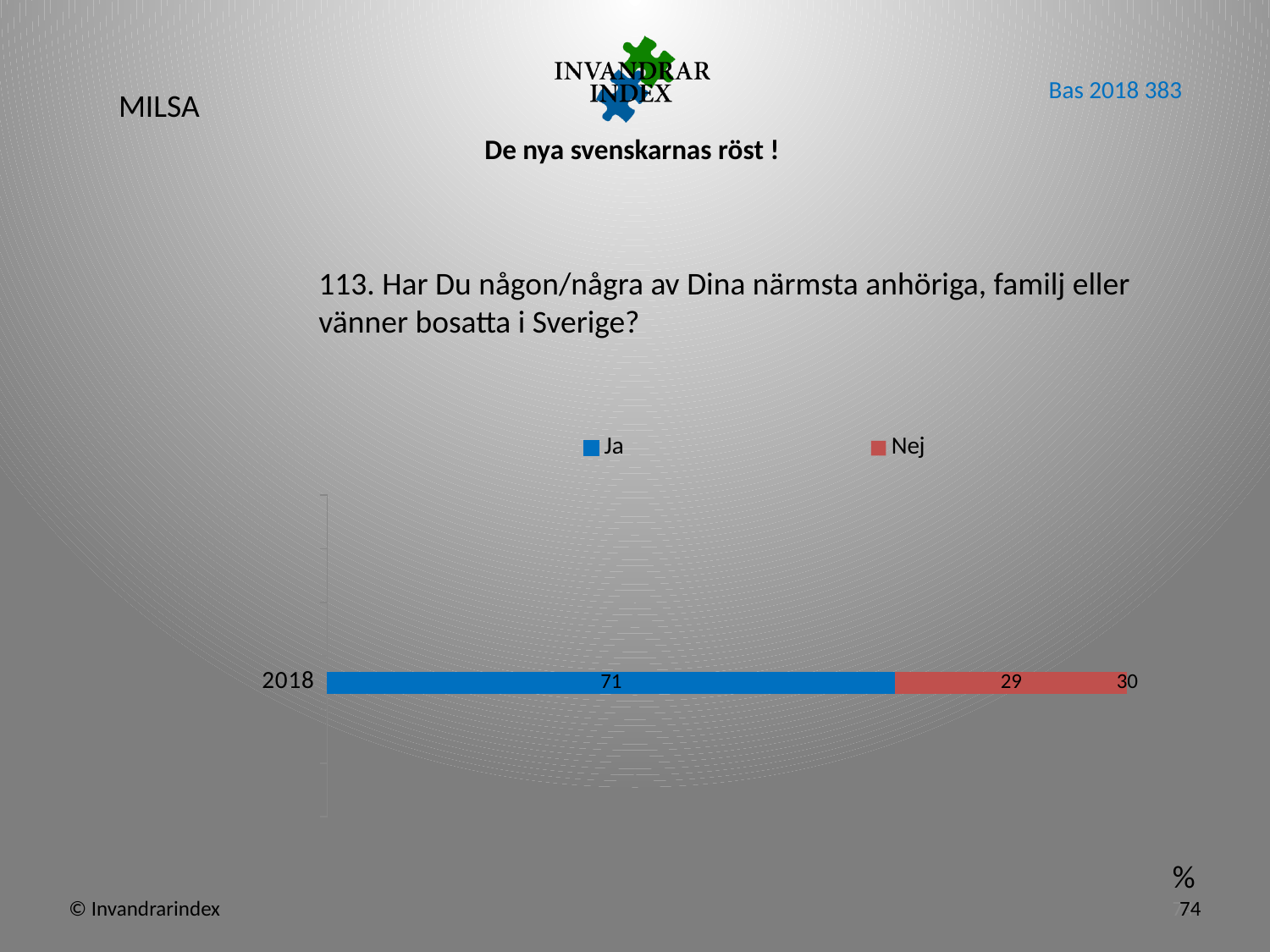
How many categories (years) are shown on the chart's axis? 1 What is the value for Ja in 2018? 71 Which series has the highest value in the chart? Ja Which colour represents the Nej series in the chart? Red What kind of chart is shown on the slide? Stacked bar chart How many series does the legend list? 2 Which year is labelled on the chart's category axis? 2018 What is the value for Nej in 2018? 29 What is the difference between the Ja and Nej values in 2018? 42 Which series has the larger value in 2018, Ja or Nej? Ja Which series has the lowest value in the chart? Nej